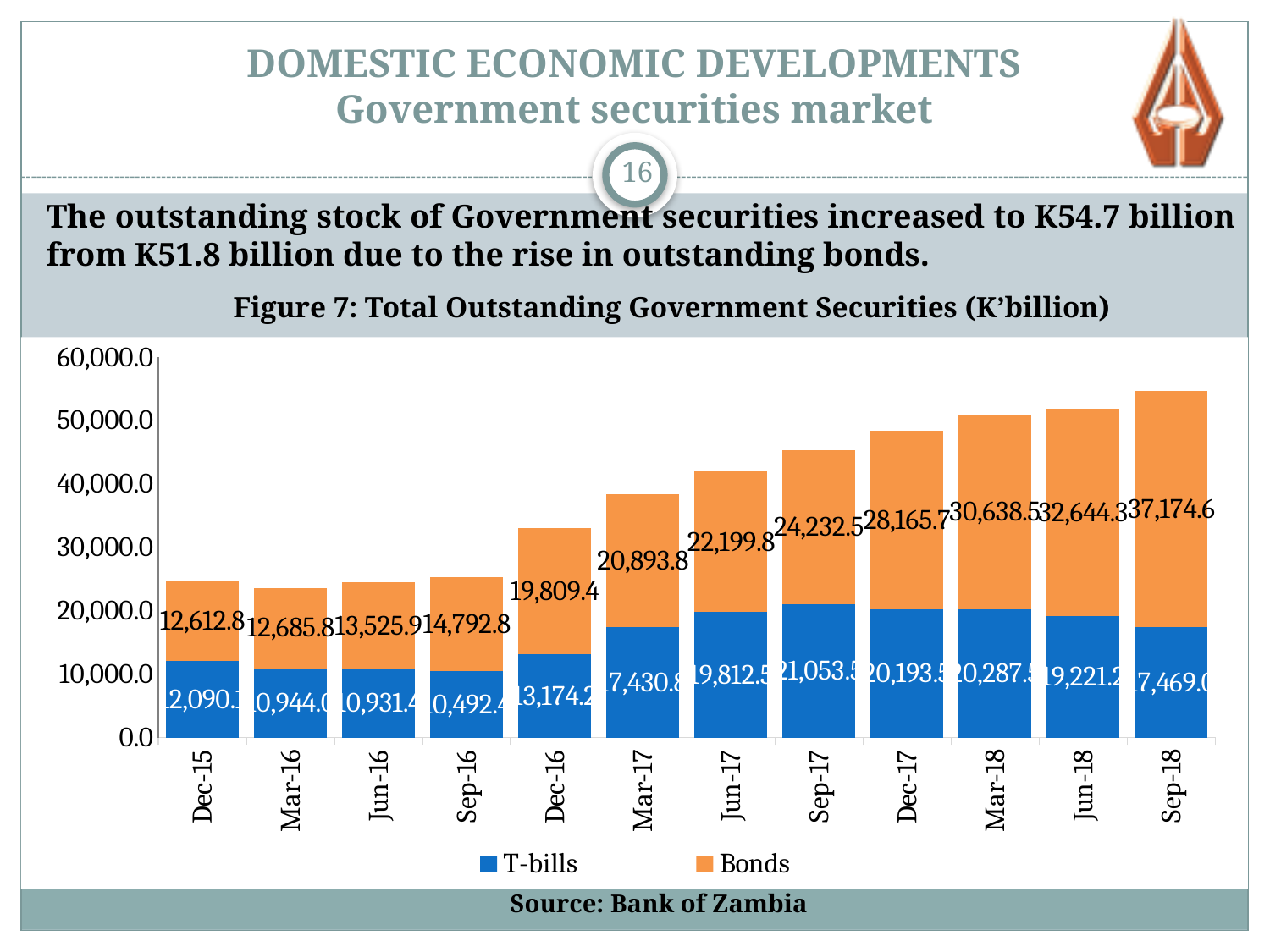
What is the value of Bonds for Sep-18? 37,174.6 How many series does the legend list? 2 In which period is the Bonds value lowest? Dec-15 In which period is the Bonds value highest? Sep-18 Do the Bonds values generally rise or fall from Dec-15 to Sep-18? Rise Which is larger, the T-bills value for Sep-17 or for Mar-18? Sep-17 What is the difference between the Bonds values for Sep-18 and Jun-18? 4,530.3 What is the value of Bonds for Dec-16? 19,809.4 How many time periods are shown on the x axis? 12 What type of chart is shown in Figure 7? Stacked bar chart What is the value of T-bills for Sep-17? 21,053.5 What is the total of the stacked bar for Sep-18? 54,643.6